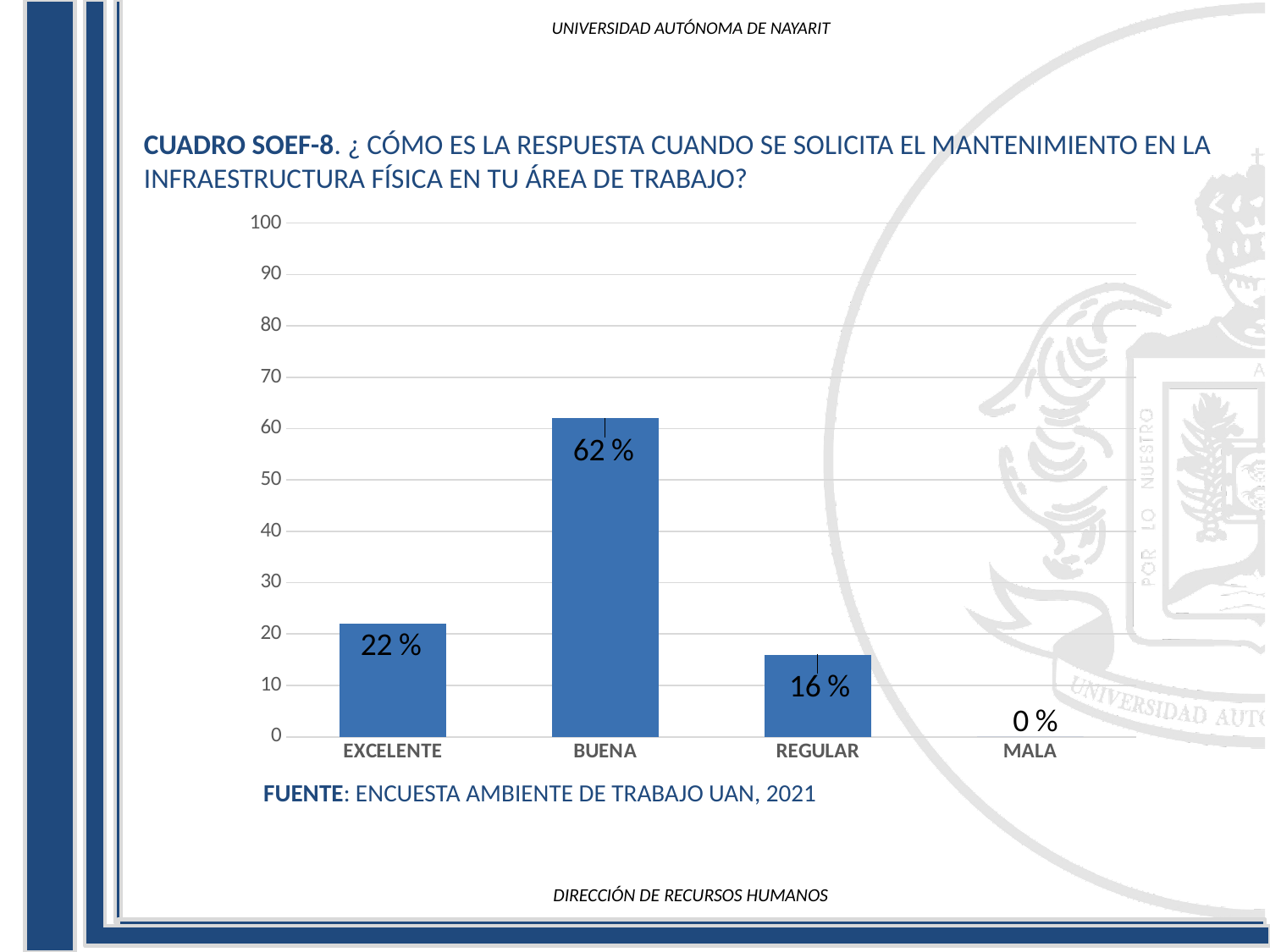
What is the difference between the values for BUENA and EXCELENTE? 40 % Which category has the lowest value? MALA What is the value for MALA? 0 % Which category has the highest value? BUENA What source is cited below the chart? ENCUESTA AMBIENTE DE TRABAJO UAN, 2021 What is the value for REGULAR? 16 % Which is larger, the value for EXCELENTE or the value for REGULAR? EXCELENTE What is the difference between the values for EXCELENTE and REGULAR? 6 % What is the value for BUENA? 62 % What is the value for EXCELENTE? 22 % What kind of chart is shown on the slide? bar chart How many categories are shown on the x axis? 4